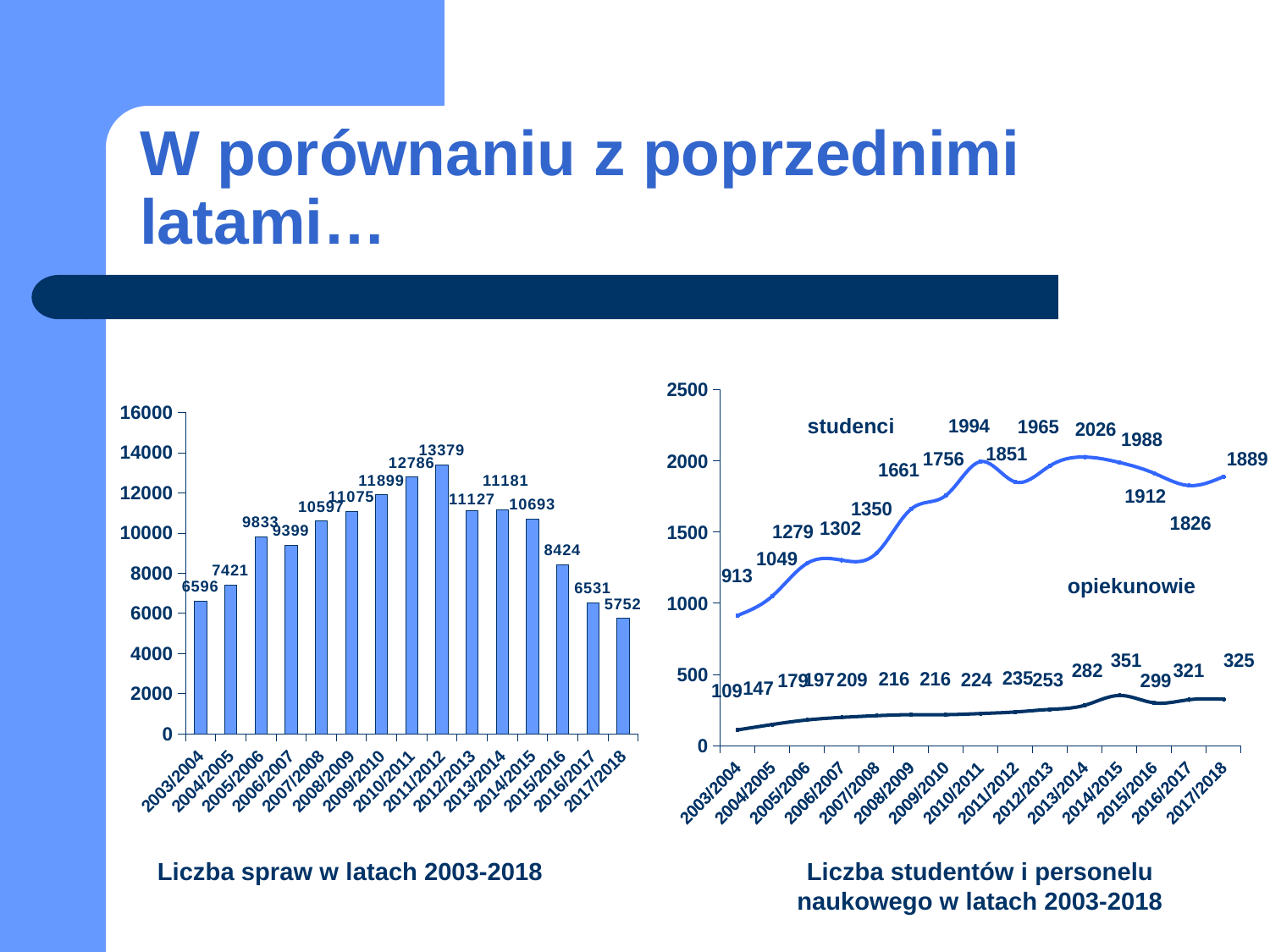
In the bar chart 'Liczba spraw w latach 2003-2018', which year has the highest value? 2011/2012 In the bar chart 'Liczba spraw w latach 2003-2018', what is the value for 2011/2012? 13379 In the line chart 'Liczba studentów i personelu naukowego w latach 2003-2018', in which year does opiekunowie reach its highest value? 2014/2015 In the bar chart 'Liczba spraw w latach 2003-2018', which year has the lowest value? 2017/2018 In the bar chart 'Liczba spraw w latach 2003-2018', what is the difference between the values for 2003/2004 and 2004/2005? 825 In the line chart 'Liczba studentów i personelu naukowego w latach 2003-2018', how many series are plotted? 2 In the line chart 'Liczba studentów i personelu naukowego w latach 2003-2018', which is larger: studenci in 2010/2011 or studenci in 2011/2012? 2010/2011 In the bar chart 'Liczba spraw w latach 2003-2018', how many years are shown on the x axis? 15 In the line chart 'Liczba studentów i personelu naukowego w latach 2003-2018', what is the value for opiekunowie in 2017/2018? 325 What type of chart is 'Liczba spraw w latach 2003-2018'? Bar chart In the line chart 'Liczba studentów i personelu naukowego w latach 2003-2018', what is the value for studenci in 2013/2014? 2026 In the bar chart 'Liczba spraw w latach 2003-2018', is the value for 2015/2016 greater or less than 8000? greater